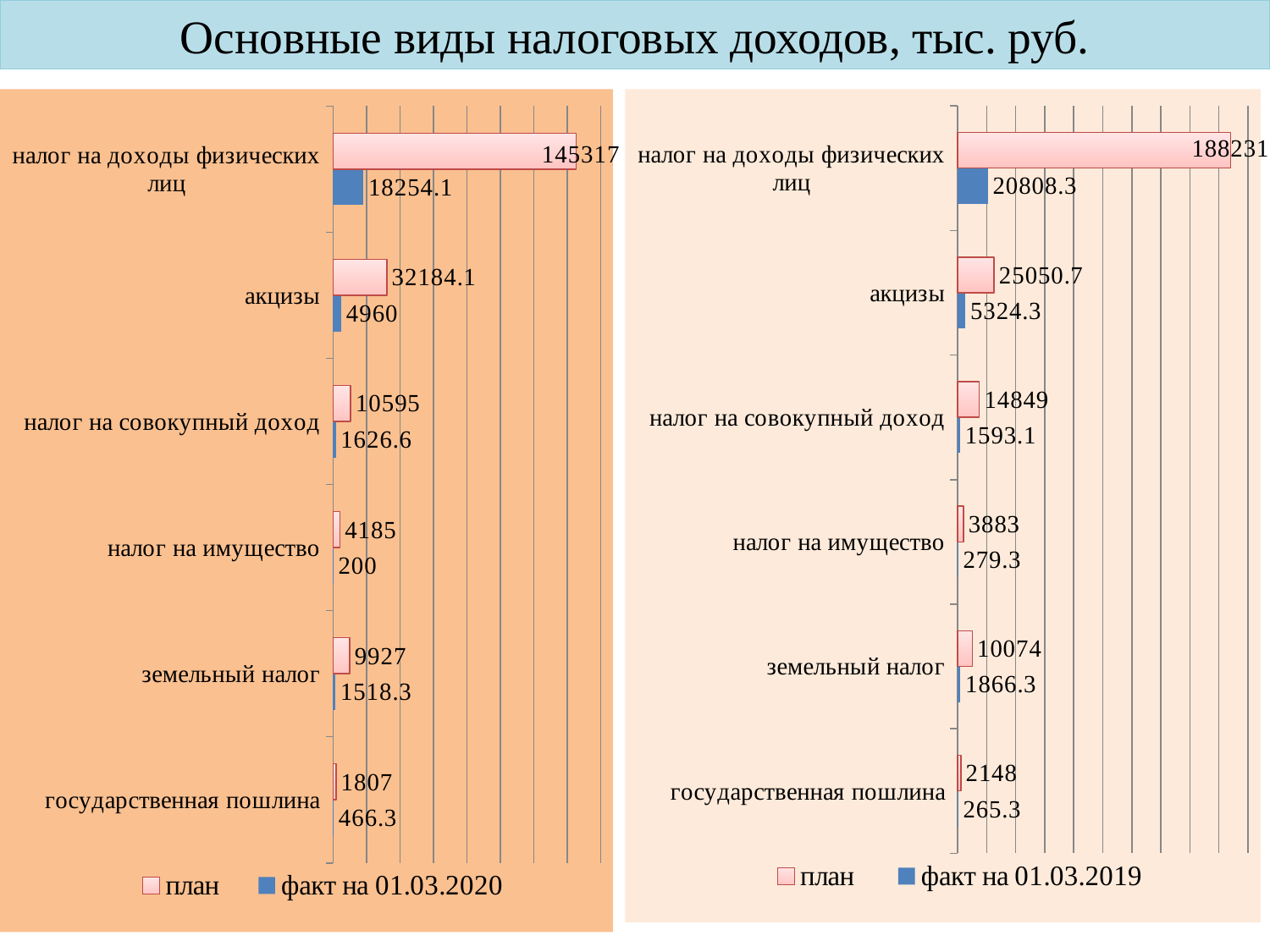
In the right chart (факт на 01.03.2019), what is the difference between the план values for акцизы and налог на совокупный доход? 10201.7 In the left chart (факт на 01.03.2020), what is the факт value for акцизы? 4960 In the left chart (факт на 01.03.2020), which category has the lowest факт value? налог на имущество In the right chart (факт на 01.03.2019), which category has the highest план value? налог на доходы физических лиц In the left chart (факт на 01.03.2020), which is larger: the факт value for земельный налог or the факт value for налог на совокупный доход? налог на совокупный доход How many series does the legend of the left chart list? 2 What type of chart is the left chart? bar chart In the right chart (факт на 01.03.2019), what is the факт value for налог на доходы физических лиц? 20808.3 In the right chart (факт на 01.03.2019), what is the план value for земельный налог? 10074 How many categories are shown in the right chart (факт на 01.03.2019)? 6 In the left chart (факт на 01.03.2020), what is the план value for налог на доходы физических лиц? 145317 In the left chart (факт на 01.03.2020), what is the difference between the план and факт values for налог на имущество? 3985